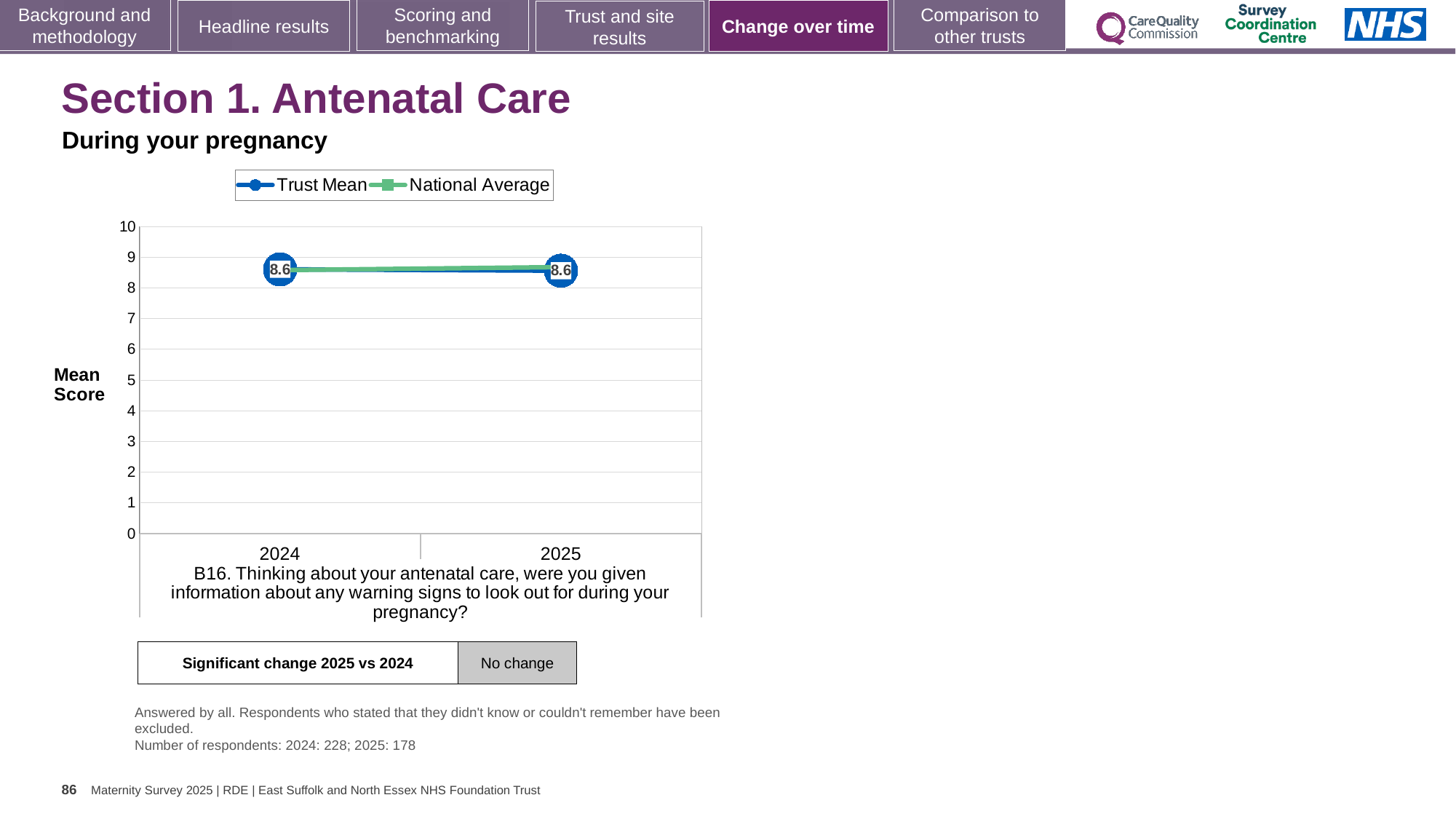
Is the Trust Mean value for 2025 greater or less than 5? greater Is the National Average value for 2024 greater or less than 8? greater What is the difference between the Trust Mean score in 2025 and in 2024? 0 How many series does the legend list? 2 How many years are shown on the x axis? 2 Is the National Average value for 2025 greater or less than 9? less What kind of chart is shown on the slide? line chart Does the Trust Mean rise, fall or stay the same from 2024 to 2025? stays the same What is the Trust Mean score for 2025? 8.6 What is the Trust Mean score for 2024? 8.6 What is the label on the y axis of the chart? Mean Score What are the two series named in the legend? Trust Mean and National Average